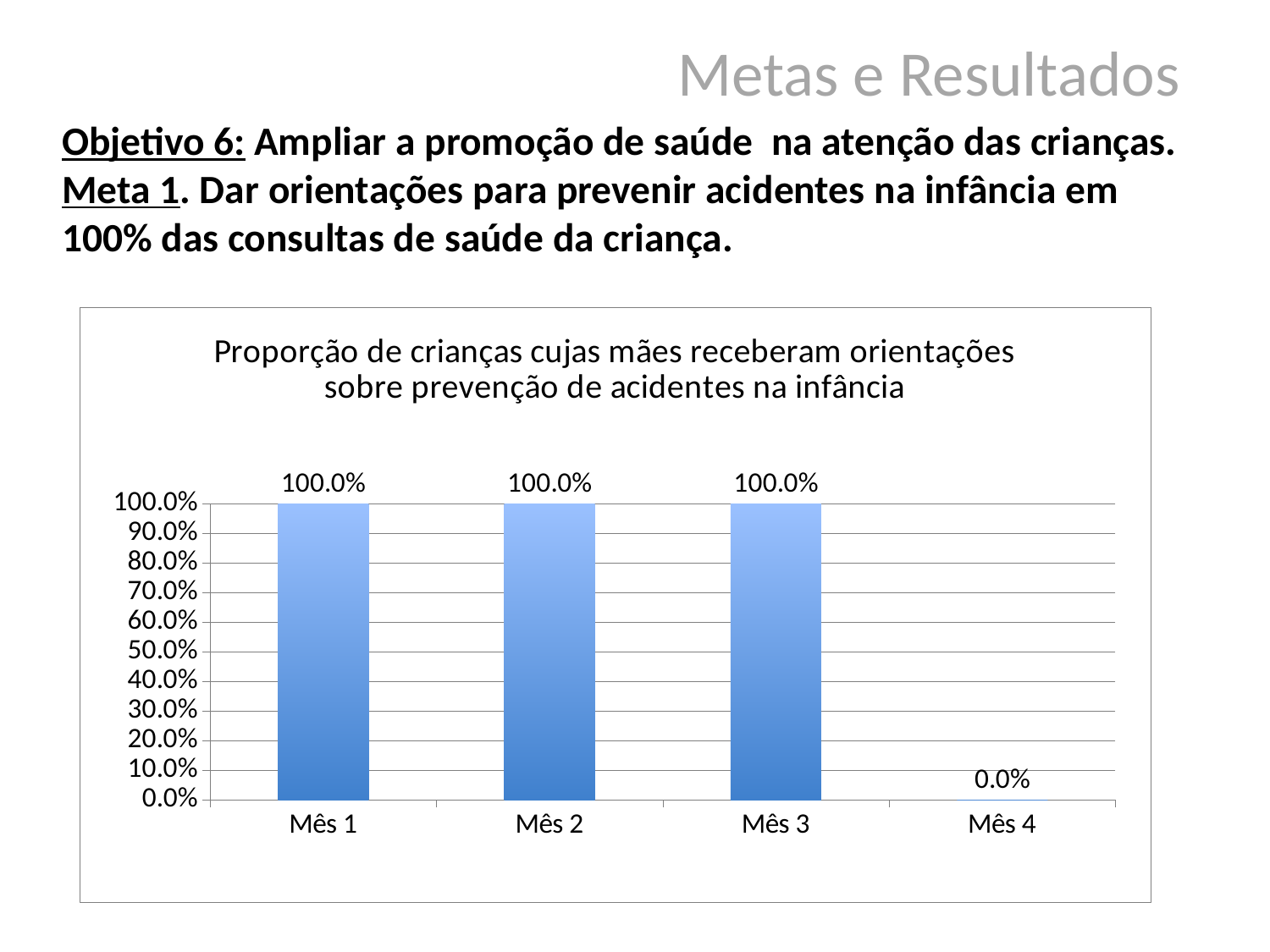
What is the value for Mês 4? 0.0% Is the value for Mês 2 greater or less than 50.0%? greater What is the value for Mês 3? 100.0% Which is larger, the value for Mês 3 or the value for Mês 4? Mês 3 Which month has the lowest value? Mês 4 How many months are shown on the x axis? 4 What is the value for Mês 1? 100.0% What is the difference between the values for Mês 2 and Mês 4? 100.0% What is the title of the chart? Proporção de crianças cujas mães receberam orientações sobre prevenção de acidentes na infância What kind of chart is shown on the slide? bar chart Do the values rise or fall from Mês 3 to Mês 4? fall What is the highest value shown on the y axis? 100.0%